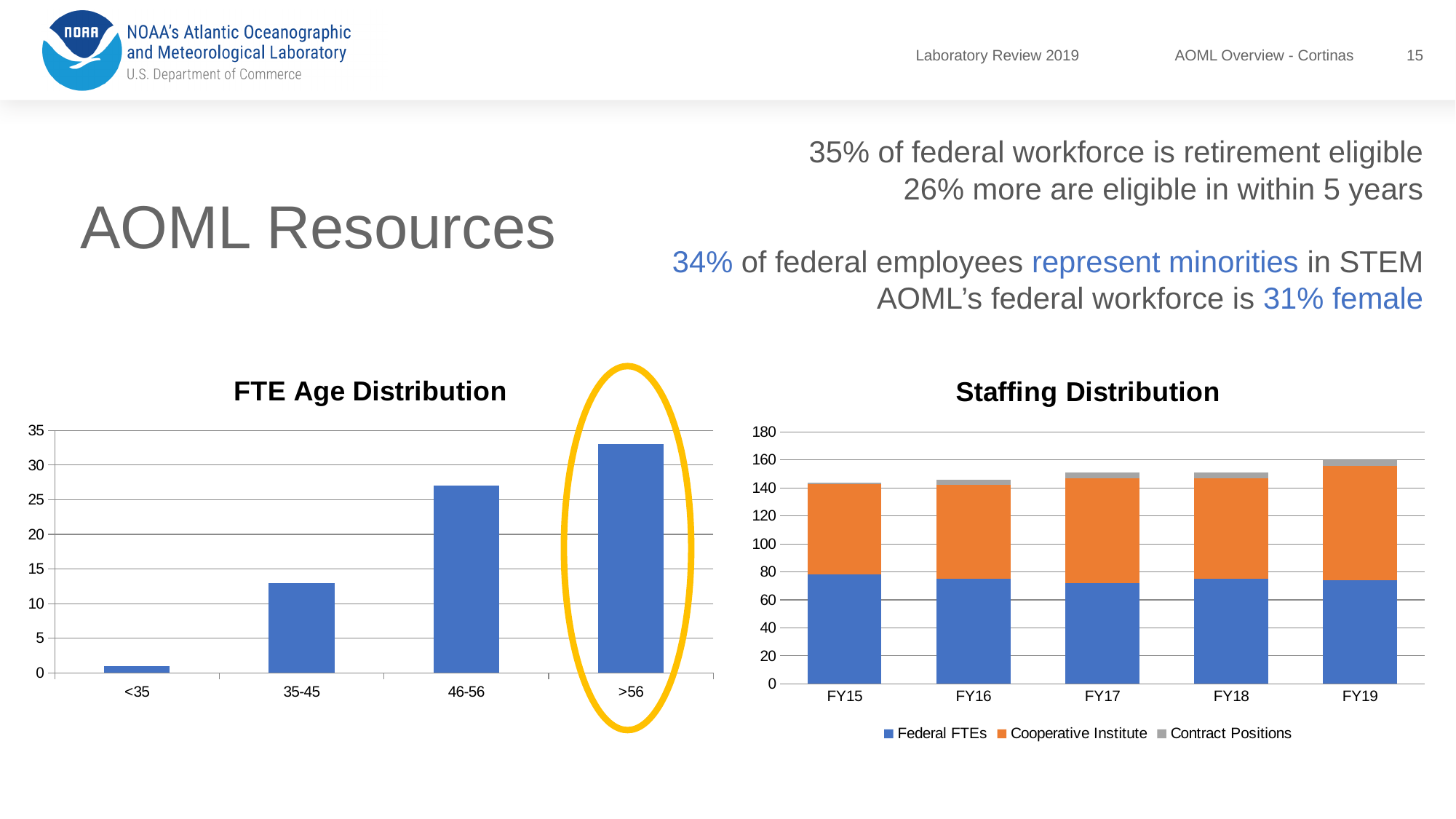
In the FTE Age Distribution chart, which is larger, the value for 35-45 or the value for 46-56? 46-56 In the FTE Age Distribution chart, do the values rise or fall as the age groups increase from <35 to >56? rise In the FTE Age Distribution chart, is the value for 35-45 greater or less than 10? greater How many series does the legend of the Staffing Distribution chart list? 3 In the Staffing Distribution chart, which series is shown in orange? Cooperative Institute In the FTE Age Distribution chart, which age group has the highest value? >56 How many fiscal years are shown in the Staffing Distribution chart? 5 In the FTE Age Distribution chart, is the value for 46-56 greater or less than 25? greater How many age groups are shown in the FTE Age Distribution chart? 4 What type of chart is the FTE Age Distribution chart? bar chart In the FTE Age Distribution chart, which age group has the lowest value? <35 In the Staffing Distribution chart, is the Federal FTEs value for FY17 greater or less than 80? less